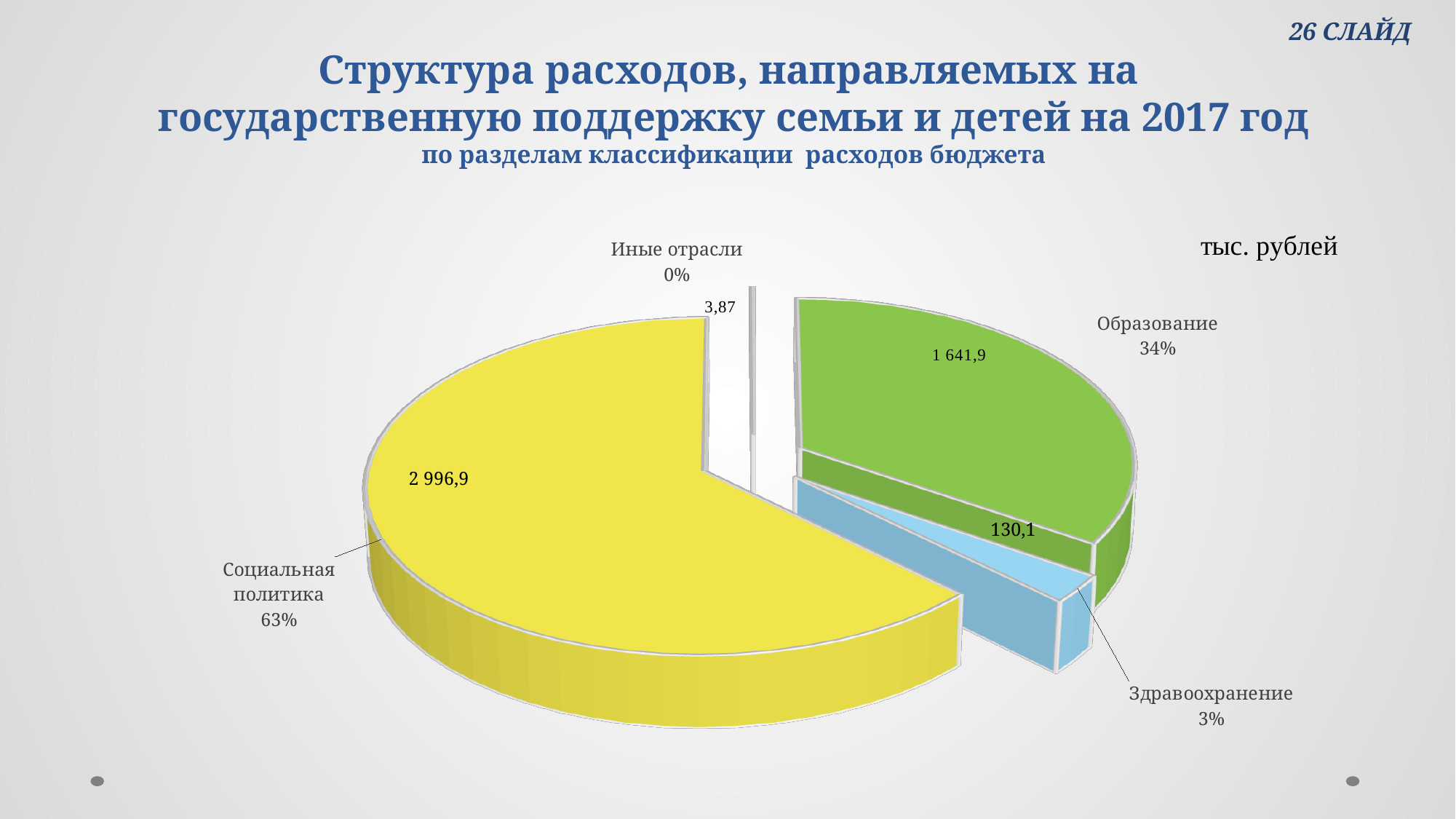
Какой тип диаграммы показан на слайде? Круговая диаграмма Какую долю в структуре расходов занимает «Образование»? 34% Какое значение (тыс. рублей) указано для сектора «Социальная политика»? 2 996,9 Какое значение (тыс. рублей) указано для сектора «Образование»? 1 641,9 Какой раздел имеет наименьшую долю расходов? Иные отрасли Что больше: расходы на «Здравоохранение» или на «Иные отрасли»? Здравоохранение На сколько тыс. рублей расходы на «Социальную политику» больше расходов на «Образование»? 1 355,0 Какое значение (тыс. рублей) указано для сектора «Иные отрасли»? 3,87 Какой раздел имеет наибольшую долю расходов? Социальная политика Какую долю в структуре расходов занимает «Социальная политика»? 63% Какое значение (тыс. рублей) указано для сектора «Здравоохранение»? 130,1 Сколько категорий (секторов) показано на круговой диаграмме? 4